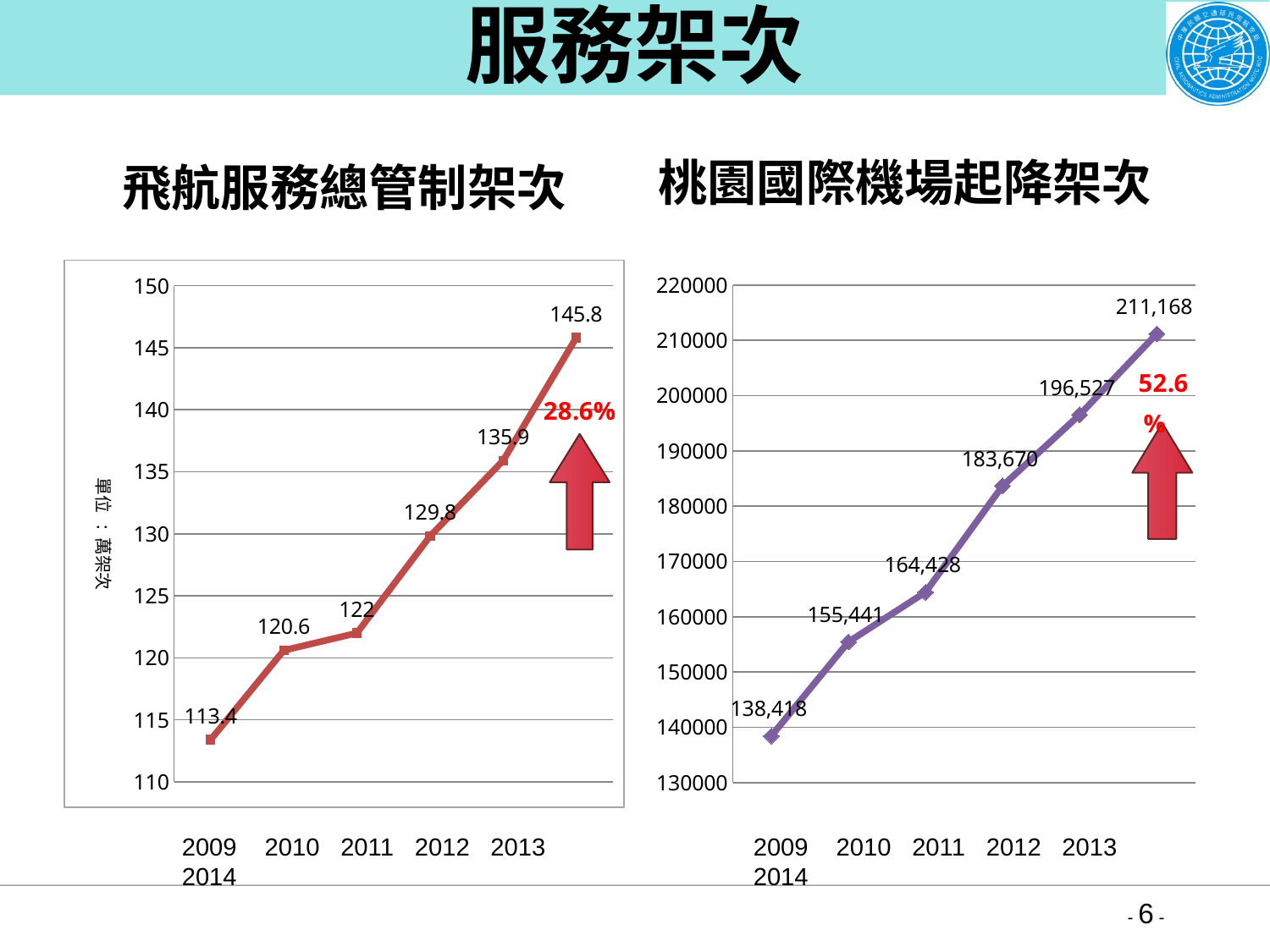
In the left chart (飛航服務總管制架次), what is the difference between the 2014 value and the 2009 value? 32.4 In the left chart (飛航服務總管制架次), which year has the highest value? 2014 In the right chart (桃園國際機場起降架次), what is the difference between the 2013 value and the 2012 value? 12,857 How many data points are plotted in the right chart (桃園國際機場起降架次)? 6 In the left chart (飛航服務總管制架次), what is the value for 2009? 113.4 In the right chart (桃園國際機場起降架次), what is the value for 2011? 164,428 In the left chart (飛航服務總管制架次), is the value for 2011 greater or less than 125? less What type of chart is the left chart (飛航服務總管制架次)? line chart In the left chart (飛航服務總管制架次), what is the value for 2012? 129.8 In the right chart (桃園國際機場起降架次), do the values rise or fall from 2009 to 2014? rise In the right chart (桃園國際機場起降架次), which year has the lowest value? 2009 In the right chart (桃園國際機場起降架次), what is the value for 2014? 211,168